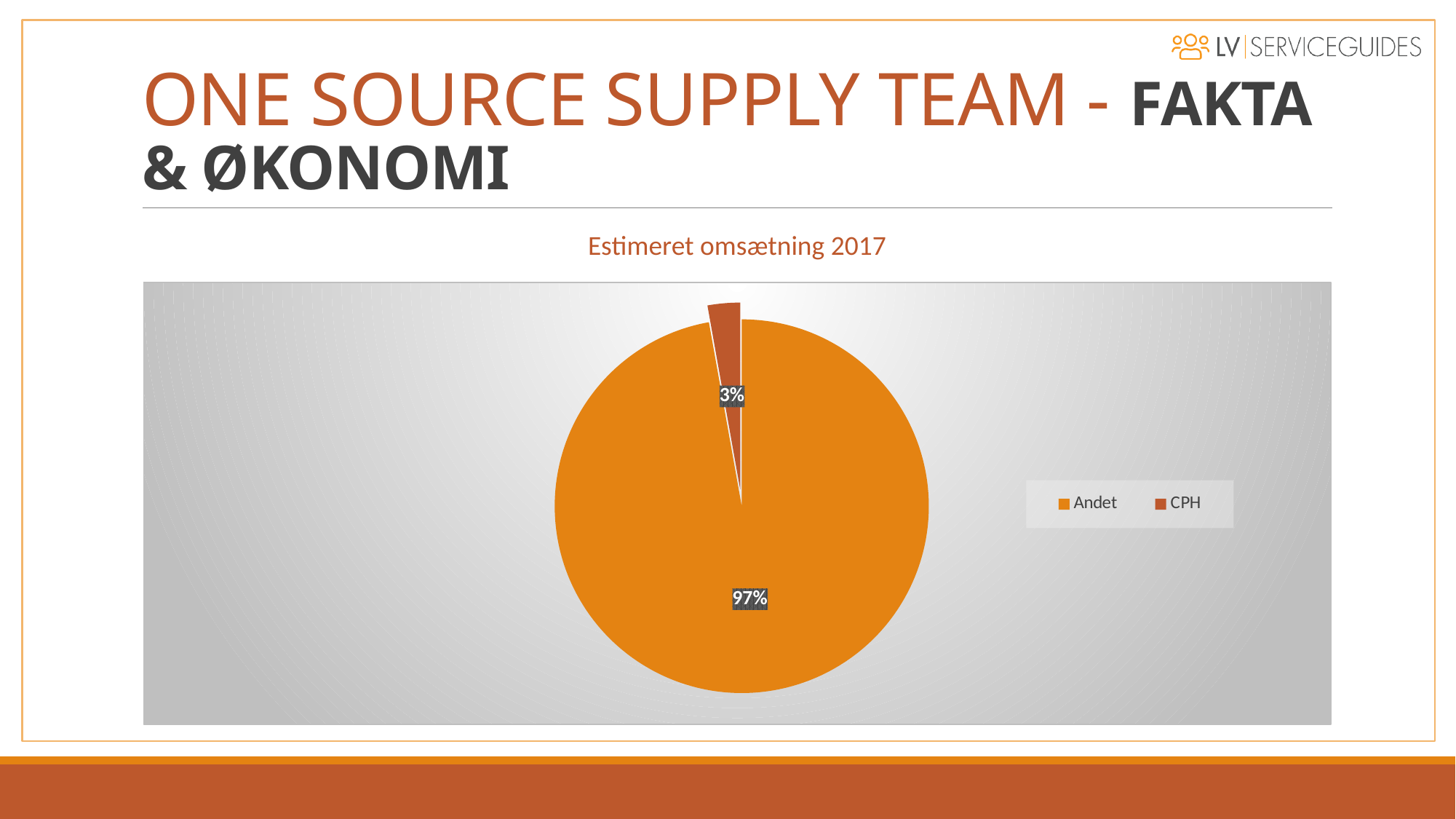
Which is larger, the Andet slice or the CPH slice? Andet What is the title of the chart? Estimeret omsætning 2017 What share of the pie does CPH represent? 3% How many slices does the pie chart have? 2 Which slice of the pie is the largest? Andet What is the total of the two slice percentages shown? 100% How many entries does the legend list? 2 What share of the pie does Andet represent? 97% What is the difference in percentage points between the Andet and CPH slices? 94 Which legend entry is shown in the darker orange-brown colour? CPH Which slice of the pie is the smallest? CPH What kind of chart is shown on the slide? pie chart